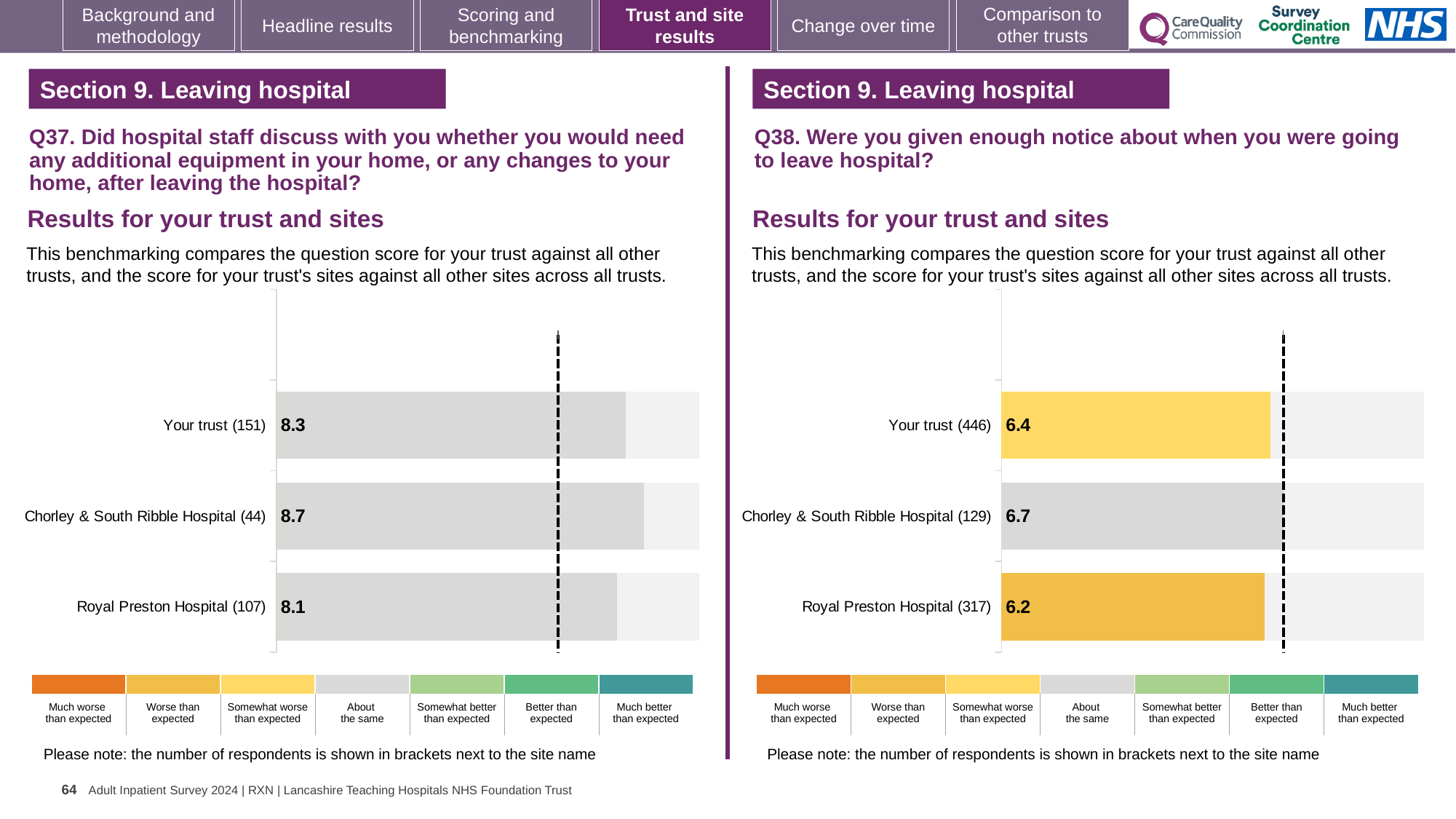
In the Q38 chart on the right, which site or trust has the highest score? Chorley & South Ribble Hospital (129) In the Q38 chart on the right, what is the score for Royal Preston Hospital (317)? 6.2 In the Q38 chart on the right, what is the difference between the scores for Chorley & South Ribble Hospital and Your trust? 0.3 In the Q38 chart on the right, which has the larger score, Your trust or Royal Preston Hospital? Your trust In the Q37 chart on the left, what is the score for Your trust (151)? 8.3 What kind of chart is used in the Q38 chart on the right? Bar chart In the Q38 chart on the right, what is the score for Your trust (446)? 6.4 In the Q37 chart on the left, what is the difference between the scores for Chorley & South Ribble Hospital and Royal Preston Hospital? 0.6 In the Q37 chart on the left, how many bars are plotted? 3 In the Q38 chart on the right, which benchmark category does the colour of the Royal Preston Hospital bar correspond to? Worse than expected In the Q37 chart on the left, what is the score for Chorley & South Ribble Hospital (44)? 8.7 In the Q37 chart on the left, which site or trust has the lowest score? Royal Preston Hospital (107)